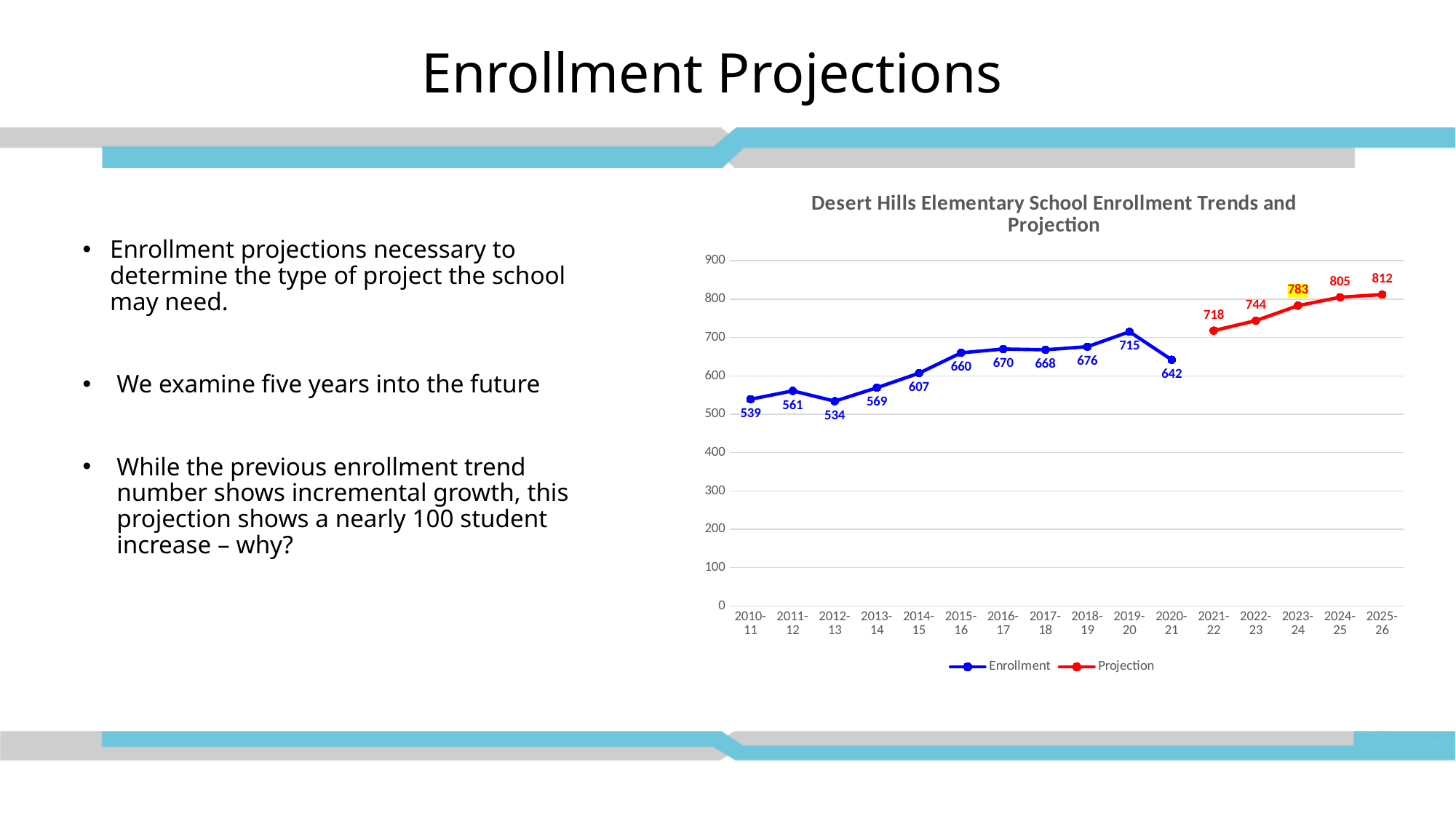
What is the Enrollment value for 2019-20? 715 What is the Projection value for 2025-26? 812 Which year has the lowest Enrollment value? 2012-13 What is the difference between the Projection values for 2025-26 and 2021-22? 94 Is the Projection value for 2023-24 greater or less than 700? greater What is the difference between the Enrollment values for 2019-20 and 2020-21? 73 What is the Enrollment value for 2012-13? 534 How many series does the legend list? 2 Which is larger, the Enrollment value for 2016-17 or for 2017-18? 2016-17 What kind of chart is shown on the slide? Line chart Do the Projection values rise or fall from 2021-22 to 2025-26? Rise Which year has the highest Enrollment value? 2019-20